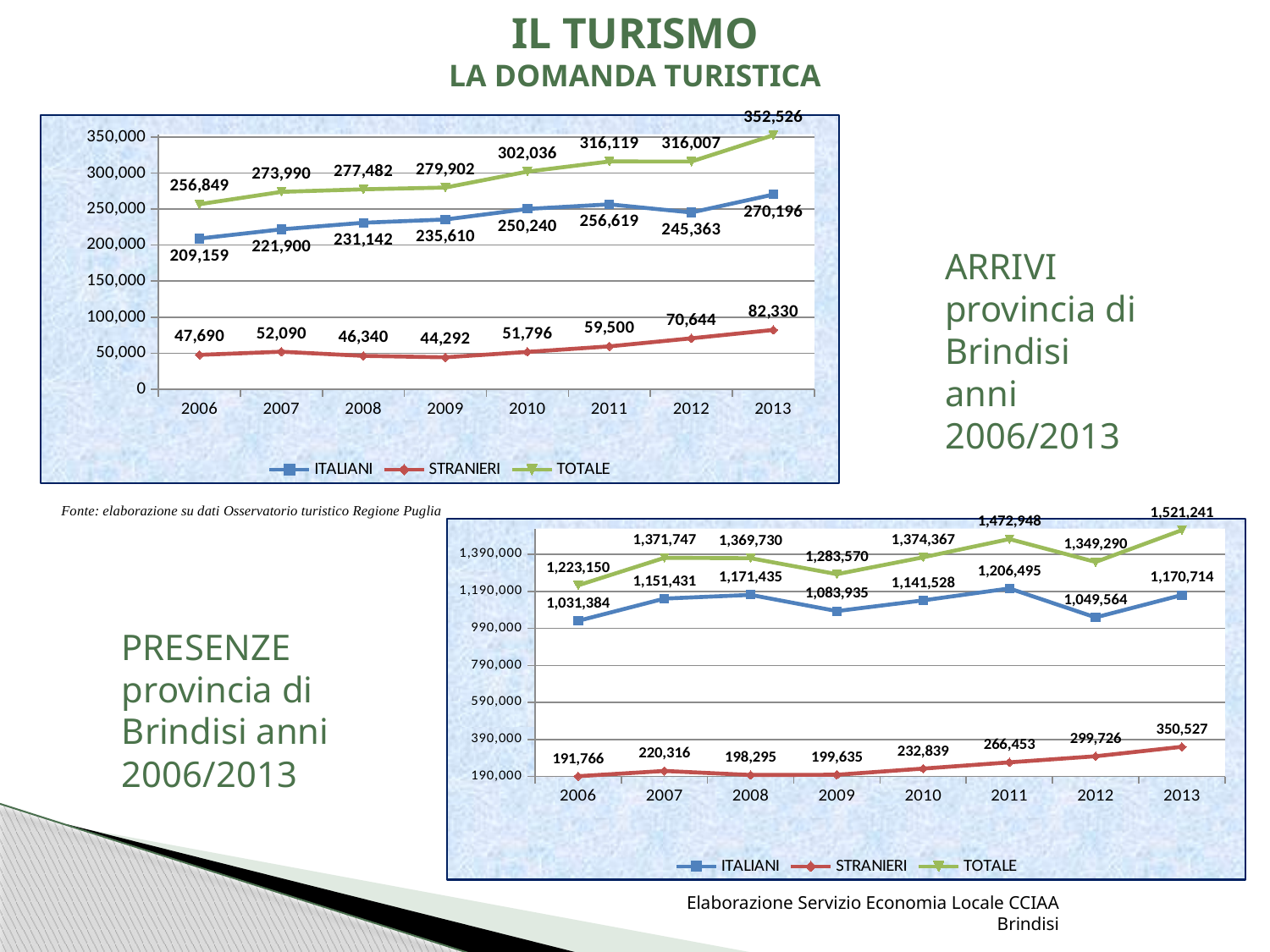
On the ARRIVI chart (top), what is the value for TOTALE in 2013? 352,526 What kind of chart is the ARRIVI chart (top)? line chart On the PRESENZE chart (bottom), how many years are shown on the x axis? 8 On the ARRIVI chart (top), in which year is the ITALIANI series lowest? 2006 On the ARRIVI chart (top), which is larger for ITALIANI: 2011 or 2012? 2011 On the PRESENZE chart (bottom), in which year is the TOTALE series highest? 2013 On the PRESENZE chart (bottom), what is the value for ITALIANI in 2011? 1,206,495 On the ARRIVI chart (top), what is the difference between ITALIANI and STRANIERI in 2013? 187,866 On the PRESENZE chart (bottom), does the STRANIERI series generally rise or fall from 2009 to 2013? rise On the ARRIVI chart (top), how many series does the legend list? 3 On the PRESENZE chart (bottom), what is the difference between the STRANIERI values for 2013 and 2006? 158,761 On the ARRIVI chart (top), what is the value for STRANIERI in 2009? 44,292